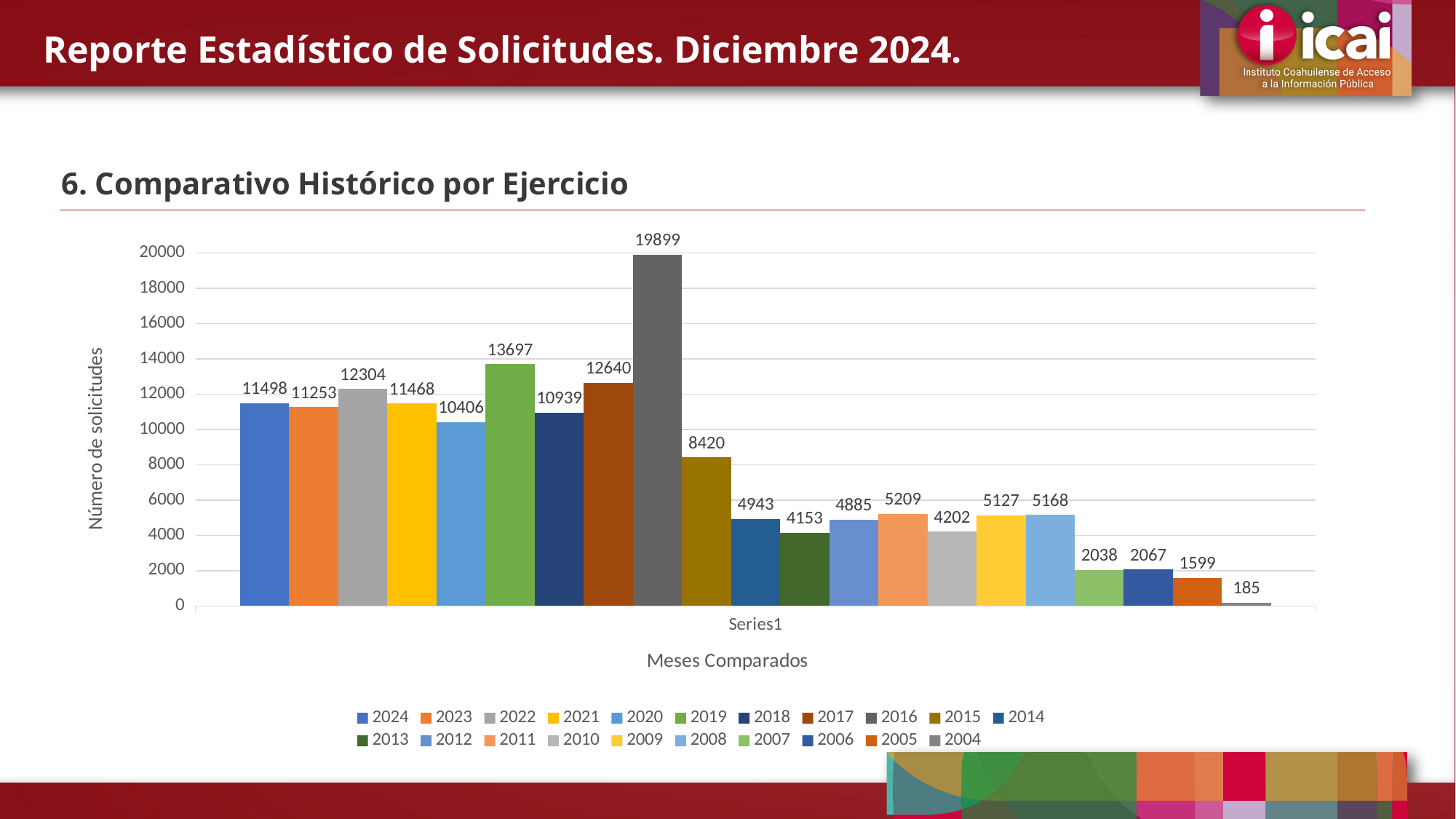
What is the difference between the values for 2016 and 2015? 11479 Which is larger, the value for 2022 or the value for 2021? 2022 Which year has the highest value? 2016 What is the value for 2016? 19899 What is the value for 2004? 185 What is the y-axis title of the chart? Número de solicitudes What is the value for 2019? 13697 What is the value for 2024? 11498 Which year has the lowest value? 2004 How many series does the legend list? 21 What kind of chart is shown? Bar chart What is the difference between the values for 2024 and 2023? 245